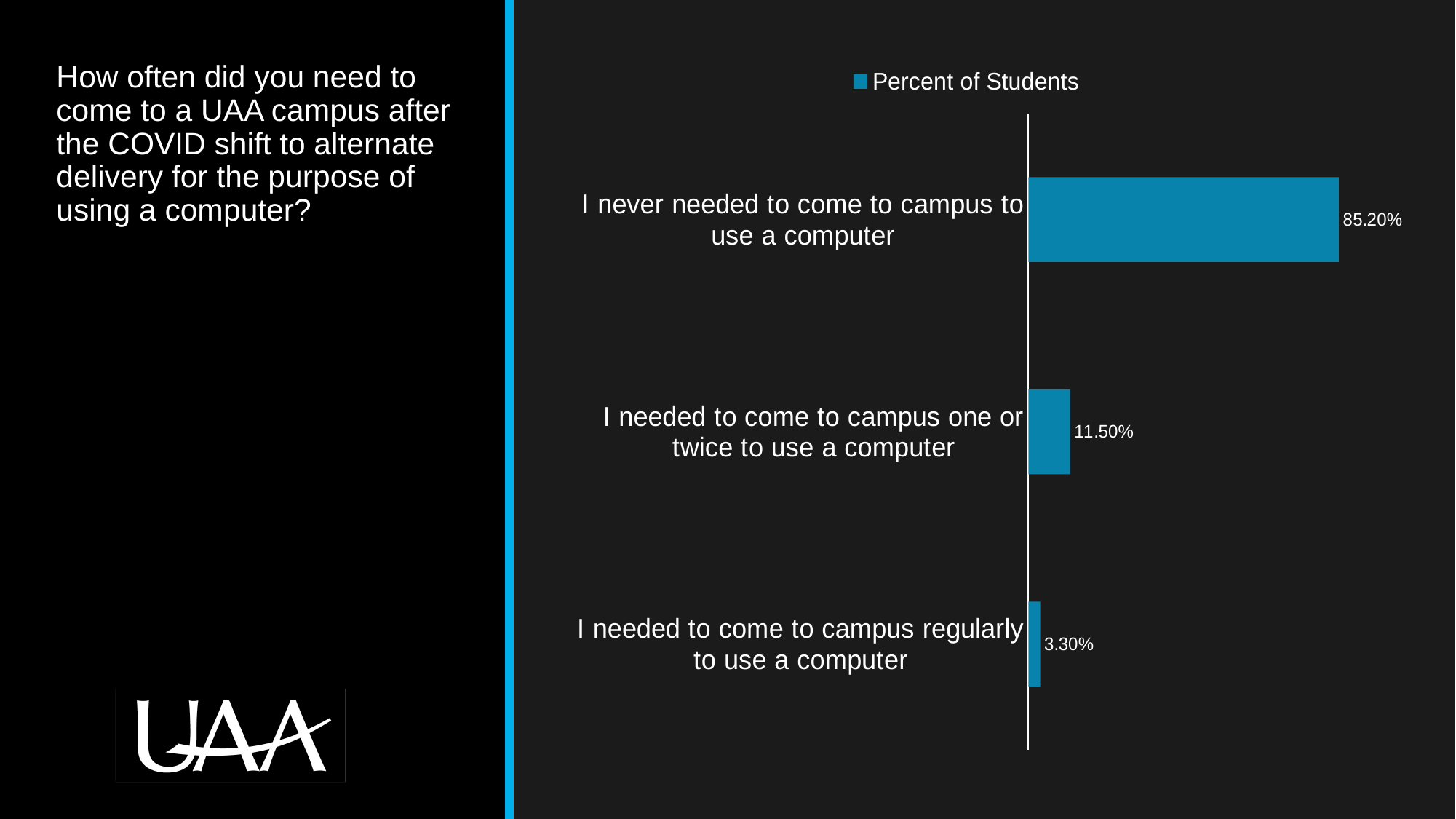
What percent of students said they never needed to come to campus to use a computer? 85.20% What percent of students needed to come to campus regularly to use a computer? 3.30% What is the difference in percent of students between 'I never needed to come to campus to use a computer' and 'I needed to come to campus one or twice to use a computer'? 73.70% What kind of chart is shown on the slide? Bar chart How many response categories are shown in the chart? 3 What is the name of the series shown in the chart legend? Percent of Students Which response category has the lowest percent of students? I needed to come to campus regularly to use a computer What percent of students needed to come to campus one or twice to use a computer? 11.50% How many series does the legend list? 1 Which has a larger percent of students: coming to campus one or twice, or coming to campus regularly? I needed to come to campus one or twice to use a computer What is the difference in percent of students between 'I needed to come to campus one or twice to use a computer' and 'I needed to come to campus regularly to use a computer'? 8.20% Which response category has the highest percent of students? I never needed to come to campus to use a computer